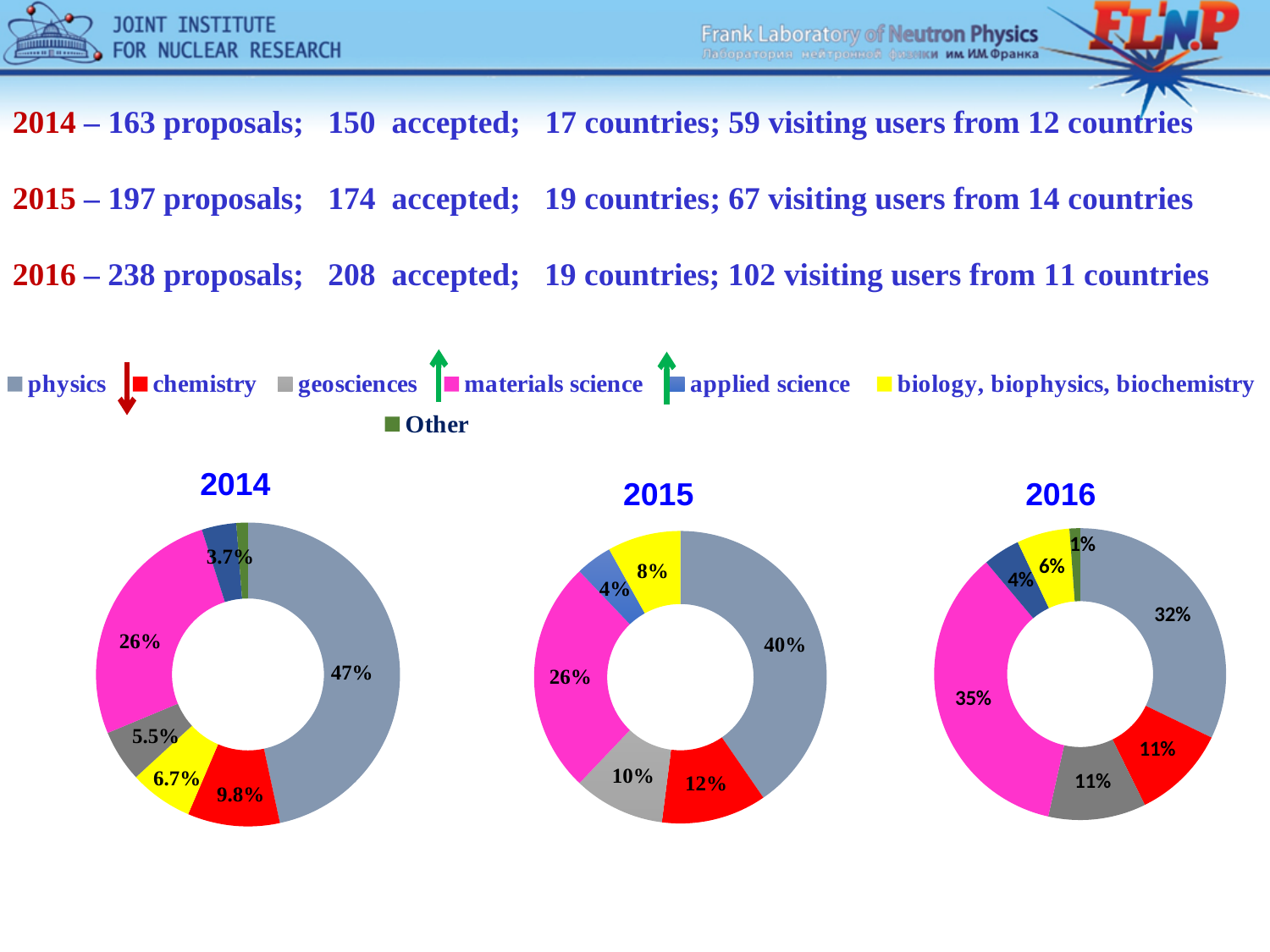
In the 2015 chart, what share is shown for materials science? 26% In the 2014 chart, what share is shown for physics? 47% What kind of chart is used for the 2014, 2015 and 2016 data? doughnut (pie) chart In the 2014 chart, what share is shown for applied science? 3.7% In the 2015 chart, which category has the smallest share? applied science In the 2015 chart, what share is shown for geosciences? 10% In the 2014 chart, what share is shown for chemistry? 9.8% In the 2014 chart, which is larger, the share for biology, biophysics, biochemistry or the share for geosciences? biology, biophysics, biochemistry In the 2016 chart, what share is shown for biology, biophysics, biochemistry? 6% In the 2016 chart, which category has the largest share? materials science In the 2016 chart, what is the difference between the shares for materials science and physics? 3% How many charts are shown on the slide? 3